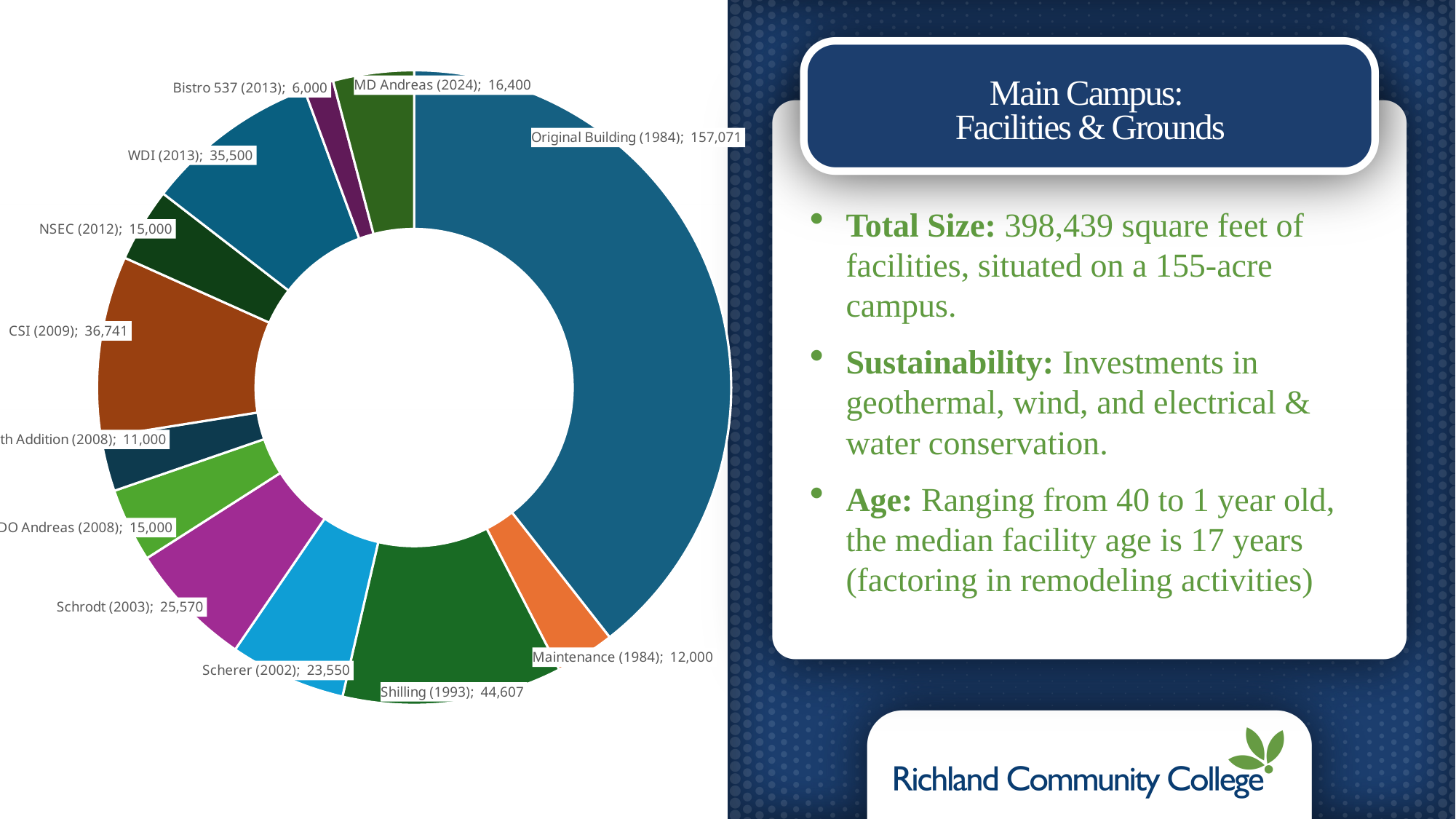
What is the value for Original Building (1984)? 157,071 What is the value for Shilling (1993)? 44,607 What is the difference between Shilling (1993) and Maintenance (1984)? 32,607 What kind of chart is shown on the slide? Pie (doughnut) chart What is the value for CSI (2009)? 36,741 How many slices does the chart have? 12 Which slice is the smallest? Bistro 537 (2013) What share of the total does Original Building (1984) represent? 39.4% What is the difference between WDI (2013) and Bistro 537 (2013)? 29,500 Which is larger, Schrodt (2003) or Scherer (2002)? Schrodt (2003) What is the value for MD Andreas (2024)? 16,400 Which slice is the largest? Original Building (1984)